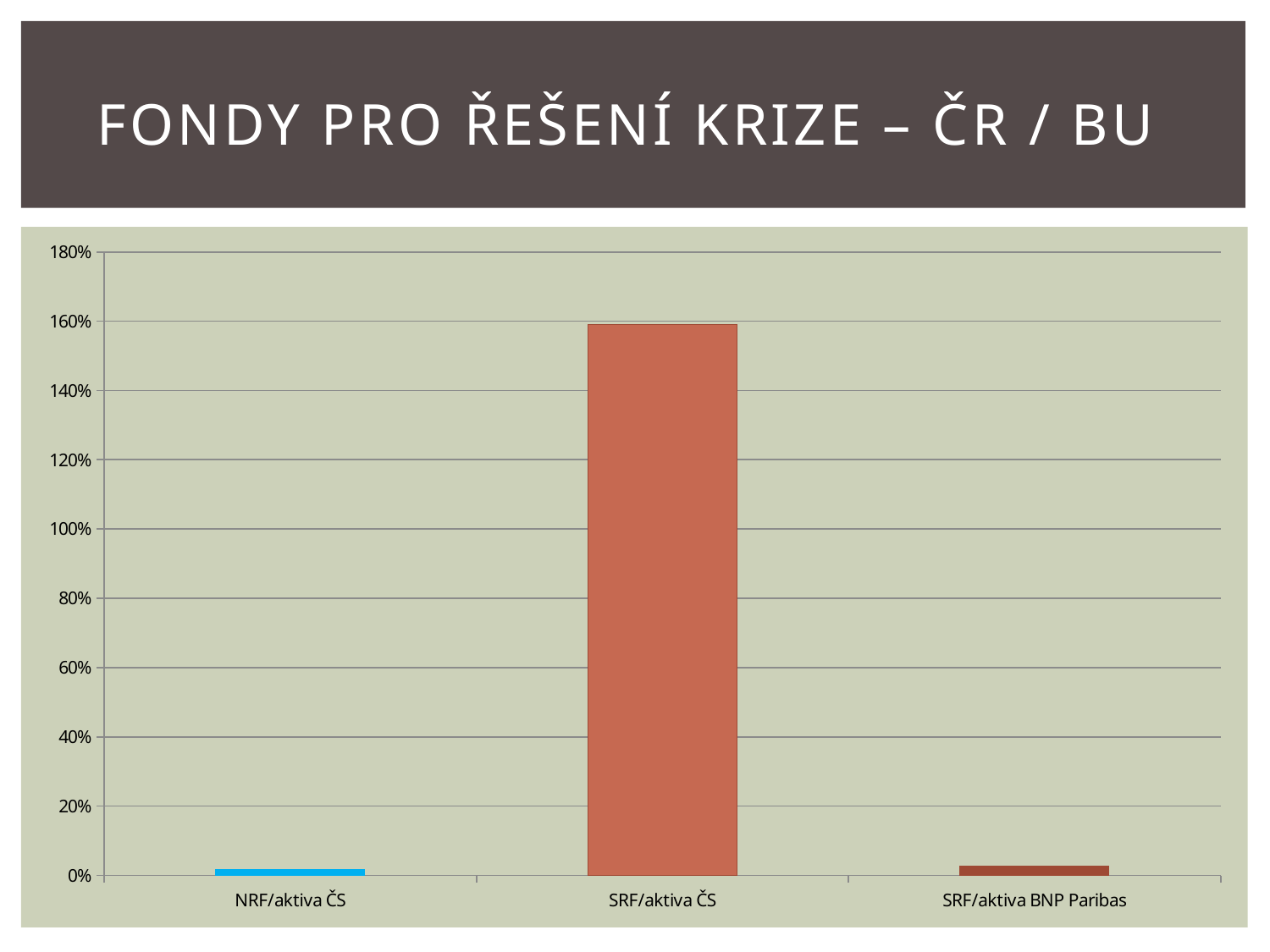
Is the value for SRF/aktiva ČS greater or less than 100%? greater What is the title of the slide containing the chart? FONDY PRO ŘEŠENÍ KRIZE – ČR / BU Is the value for SRF/aktiva BNP Paribas greater or less than 20%? less What is the highest value shown on the y axis of the chart? 180% Is the value for NRF/aktiva ČS greater or less than 20%? less How many categories are shown on the x axis of the chart? 3 Which category has the highest value in the chart? SRF/aktiva ČS Which is larger, the value for NRF/aktiva ČS or the value for SRF/aktiva ČS? SRF/aktiva ČS What kind of chart is shown on the slide? bar chart Which is larger, the value for SRF/aktiva ČS or the value for SRF/aktiva BNP Paribas? SRF/aktiva ČS